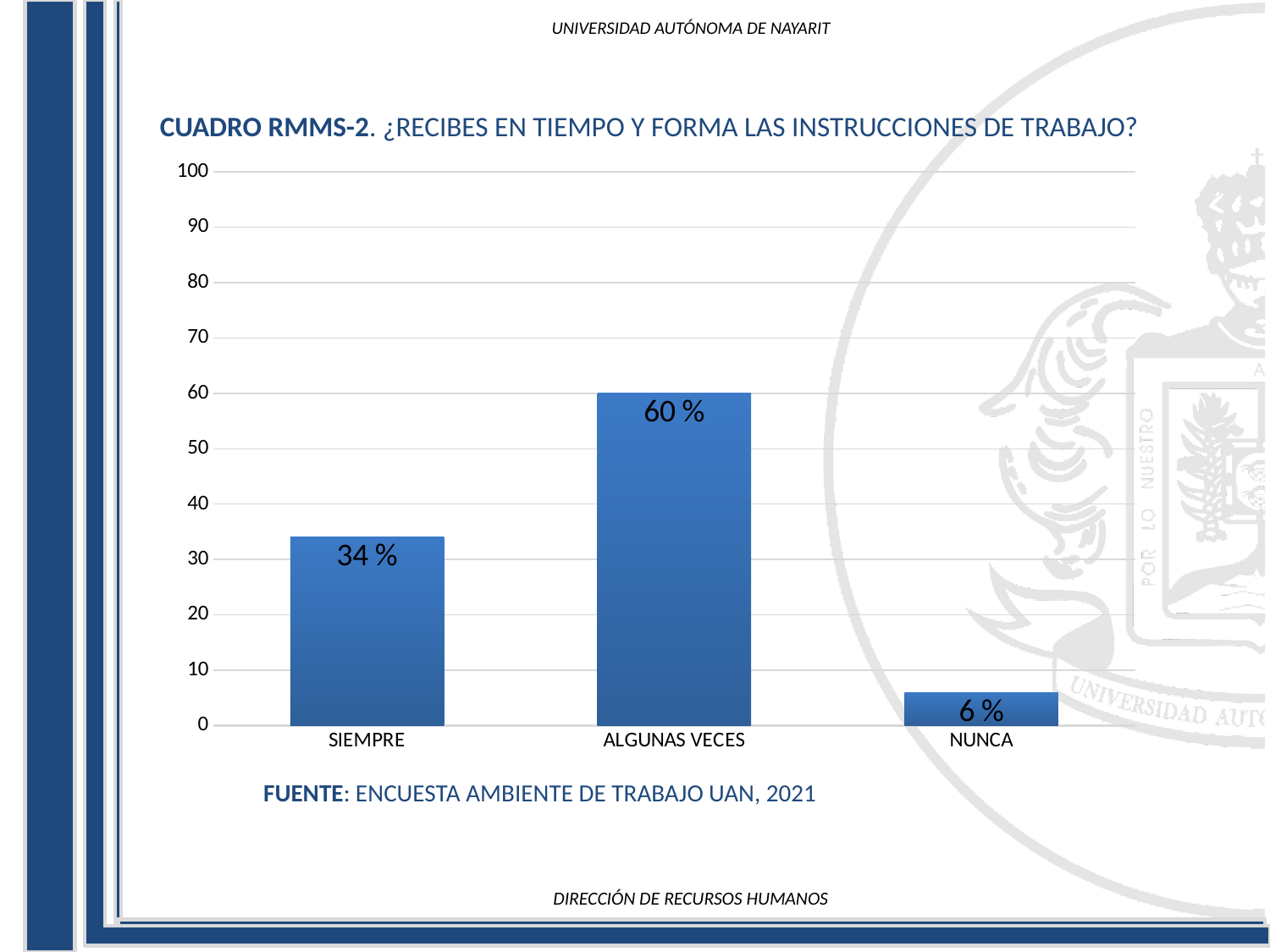
Is the value for ALGUNAS VECES greater or less than 50? greater What kind of chart is shown on the slide? bar chart How many categories are shown on the x axis? 3 What is the difference between the values for ALGUNAS VECES and SIEMPRE? 26 % Which category has the lowest value? NUNCA What is the value for SIEMPRE? 34 % What is the value for NUNCA? 6 % What is the difference between the values for SIEMPRE and NUNCA? 28 % Which is larger, the value for SIEMPRE or the value for NUNCA? SIEMPRE What is the value for ALGUNAS VECES? 60 % Which category has the highest value? ALGUNAS VECES What is the source cited below the chart? ENCUESTA AMBIENTE DE TRABAJO UAN, 2021